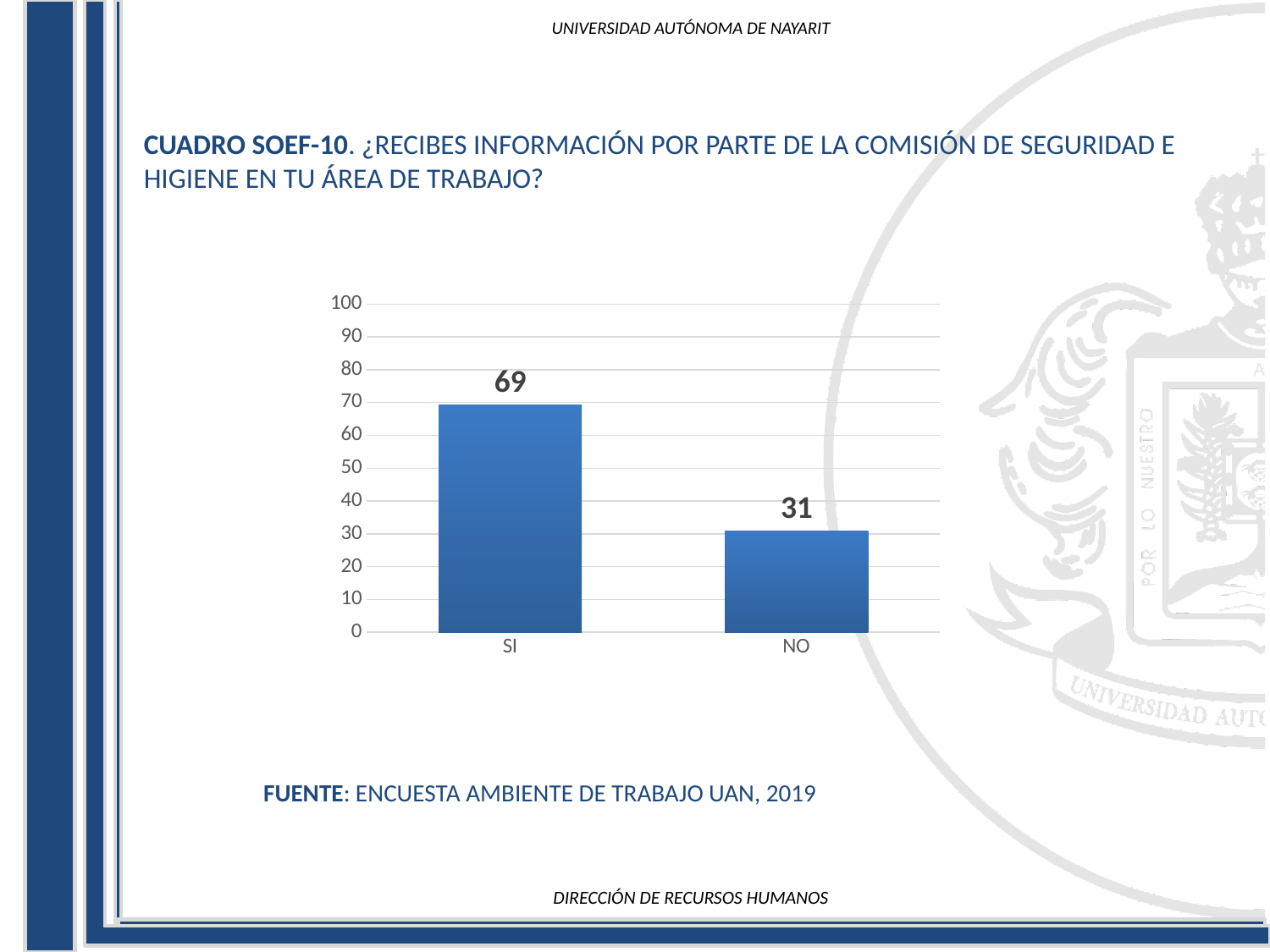
Is the value for SI greater or less than 60? greater How many categories are shown on the x axis? 2 Which is larger, the value for SI or the value for NO? SI What is the value for NO? 31 What is the difference between the values for SI and NO? 38 Which category has the highest value? SI What is the value for SI? 69 What is the maximum value shown on the vertical axis? 100 Is the value for NO greater or less than 40? less What is the total of the values for SI and NO? 100 What kind of chart is shown on the slide? bar chart Which category has the lowest value? NO